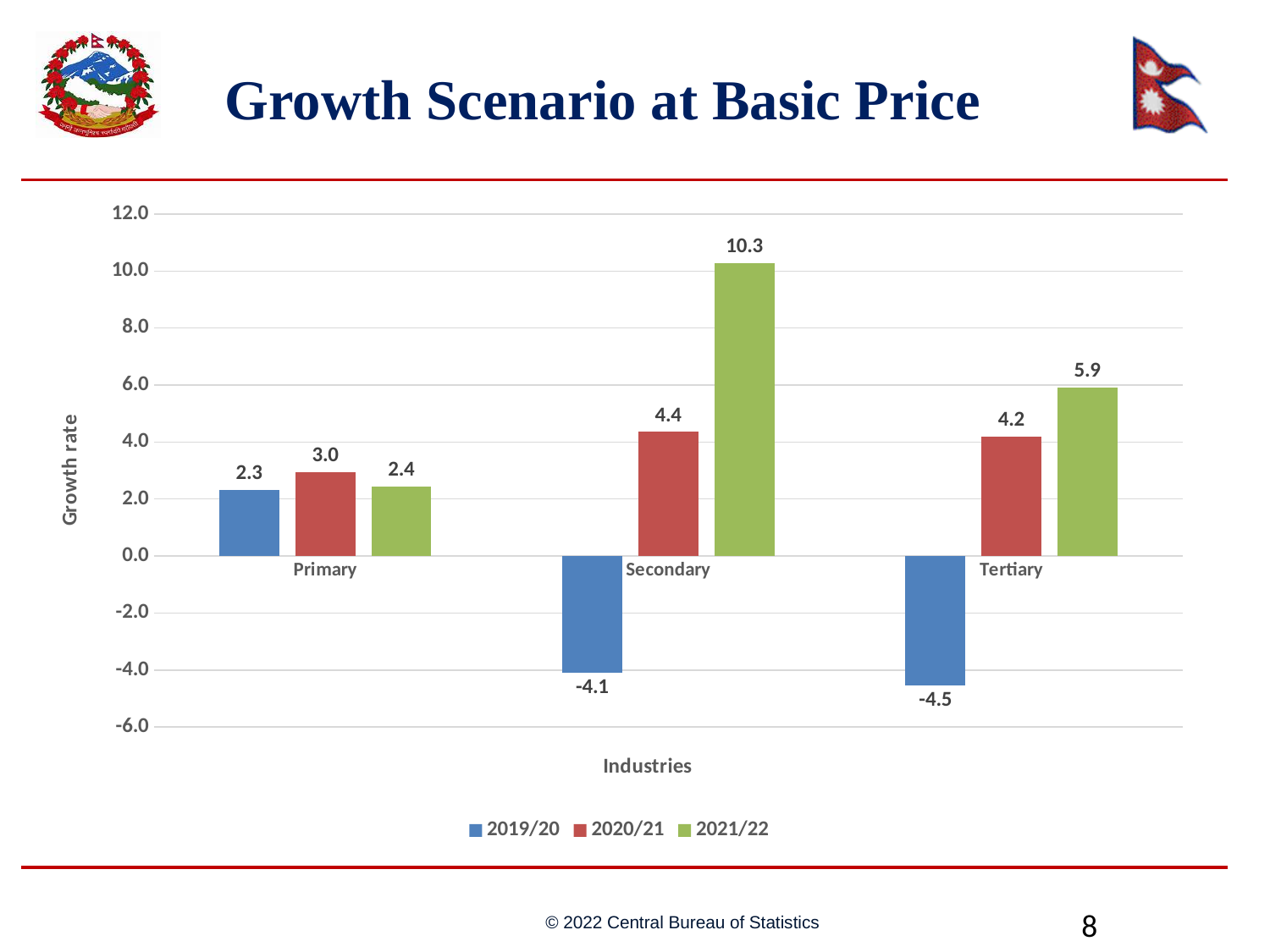
Which is larger, the 2020/21 growth rate for Secondary or for Tertiary? Secondary What is the growth rate for the Secondary industry in 2021/22? 10.3 How many industries are shown on the x axis? 3 What kind of chart is shown on the slide? Bar chart What is the title of the chart on the slide? Growth Scenario at Basic Price What is the growth rate for the Primary industry in 2020/21? 3.0 How many series does the legend list? 3 What is the growth rate for the Tertiary industry in 2019/20? -4.5 Which industry has the lowest growth rate in 2019/20? Tertiary Which industry has the highest growth rate in 2021/22? Secondary Is the 2021/22 growth rate for the Tertiary industry greater or less than 4.0? greater What is the difference between the 2021/22 and 2020/21 growth rates for the Secondary industry? 5.9